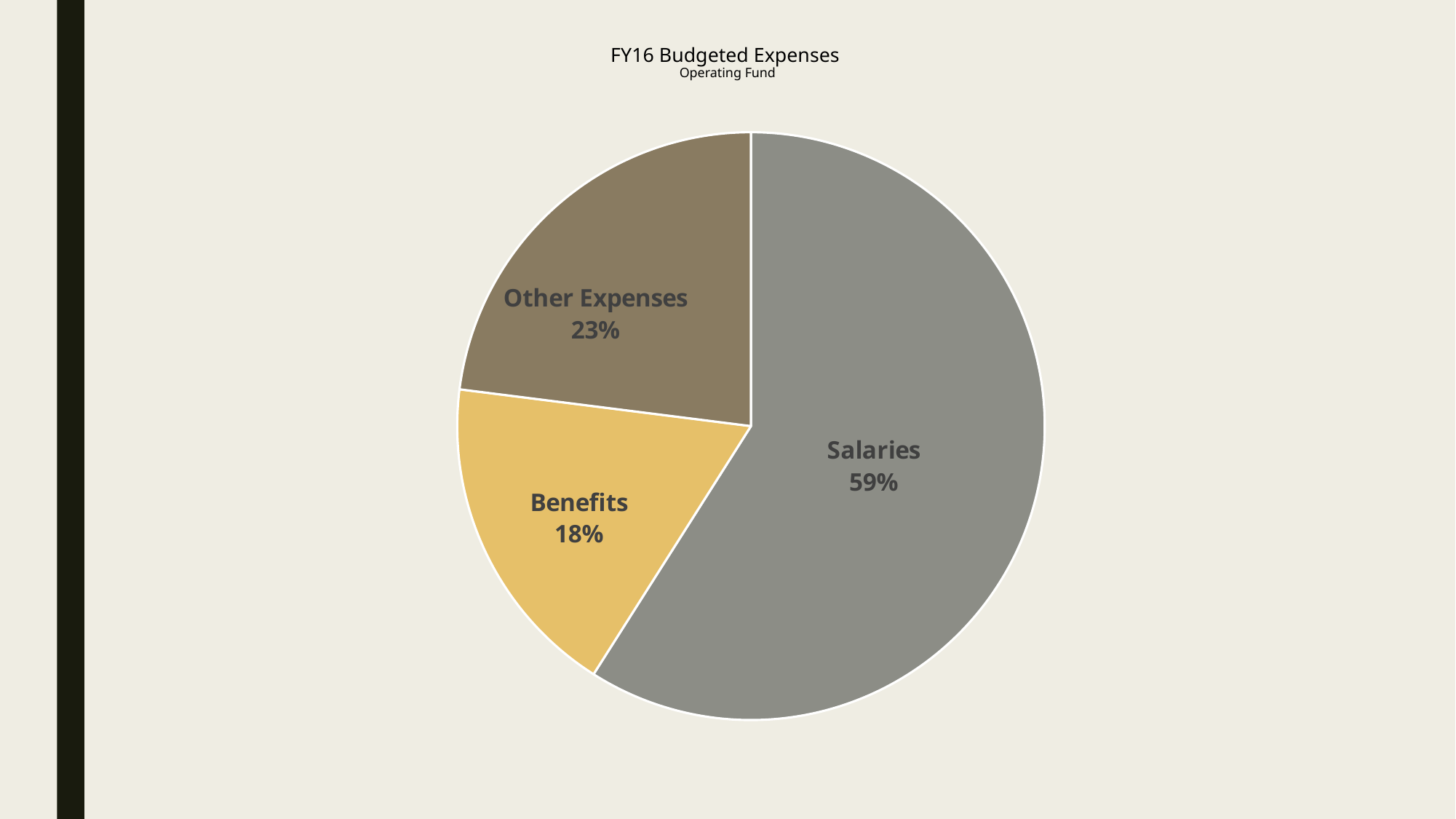
What is the subtitle shown under the chart title? Operating Fund What kind of chart is shown on the slide? pie chart What share of the pie is Benefits? 18% What share of the pie is Salaries? 59% How many slices does the pie chart have? 3 What is the difference in percentage points between Other Expenses and Benefits? 5 Which is larger, Benefits or Other Expenses? Other Expenses What is the title of the chart? FY16 Budgeted Expenses What share of the pie is Other Expenses? 23% What is the difference in percentage points between Salaries and Other Expenses? 36 Which category has the largest slice? Salaries Which category has the smallest slice? Benefits